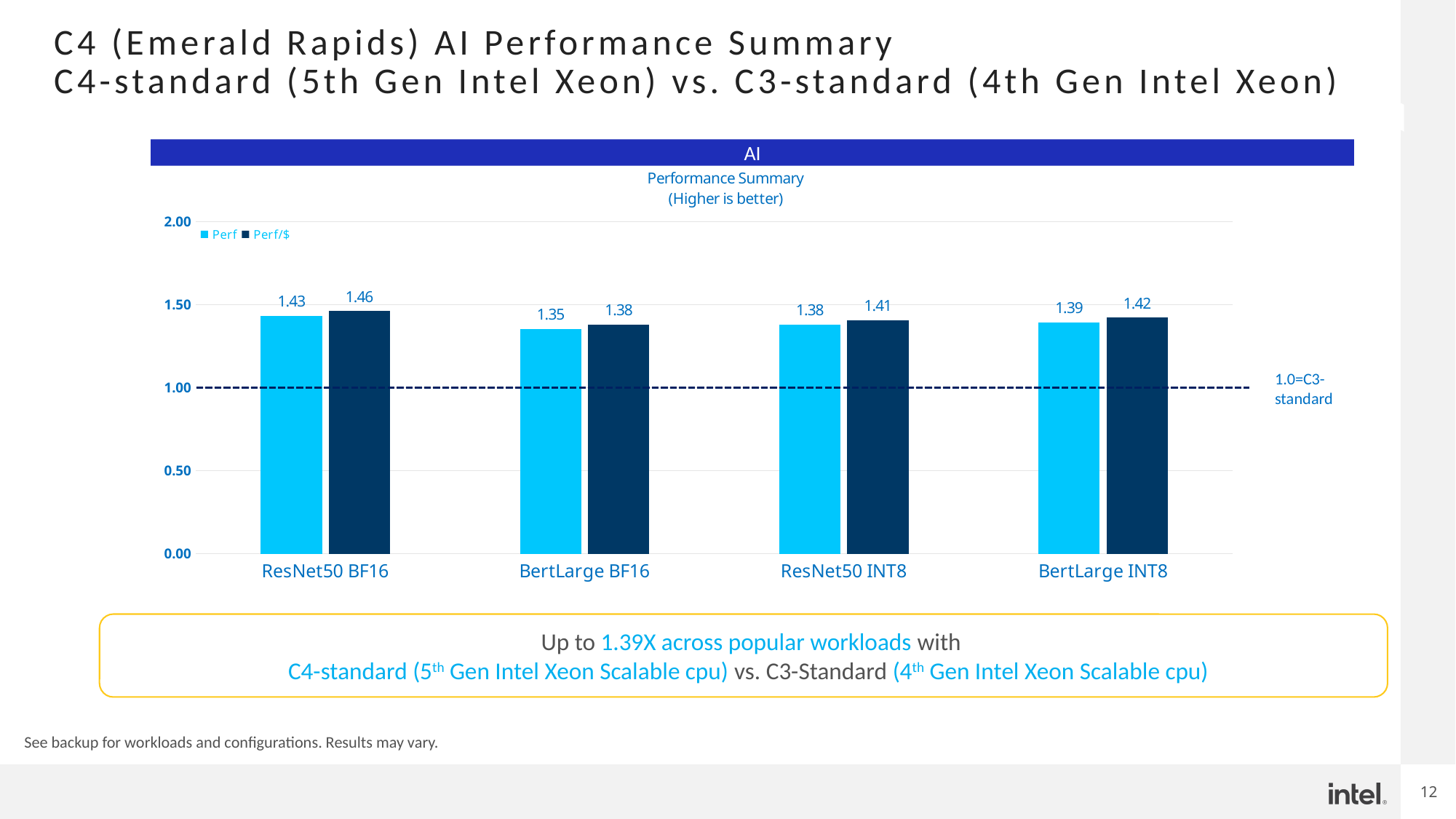
What is the Perf/$ value for BertLarge INT8? 1.42 Which workload has the lowest Perf value? BertLarge BF16 What is the Perf value for BertLarge BF16? 1.35 What is the difference between the Perf/$ and Perf values for ResNet50 INT8? 0.03 Is the Perf/$ value for BertLarge BF16 greater or less than 1.00? greater How many series does the legend list? 2 How many workloads are shown on the x axis? 4 What kind of chart is shown on the slide? bar chart What is the Perf value for ResNet50 BF16? 1.43 What does the dashed horizontal line at 1.00 represent? 1.0=C3-standard Which workload has the highest Perf/$ value? ResNet50 BF16 Which is larger, the Perf value for ResNet50 BF16 or the Perf value for BertLarge INT8? ResNet50 BF16